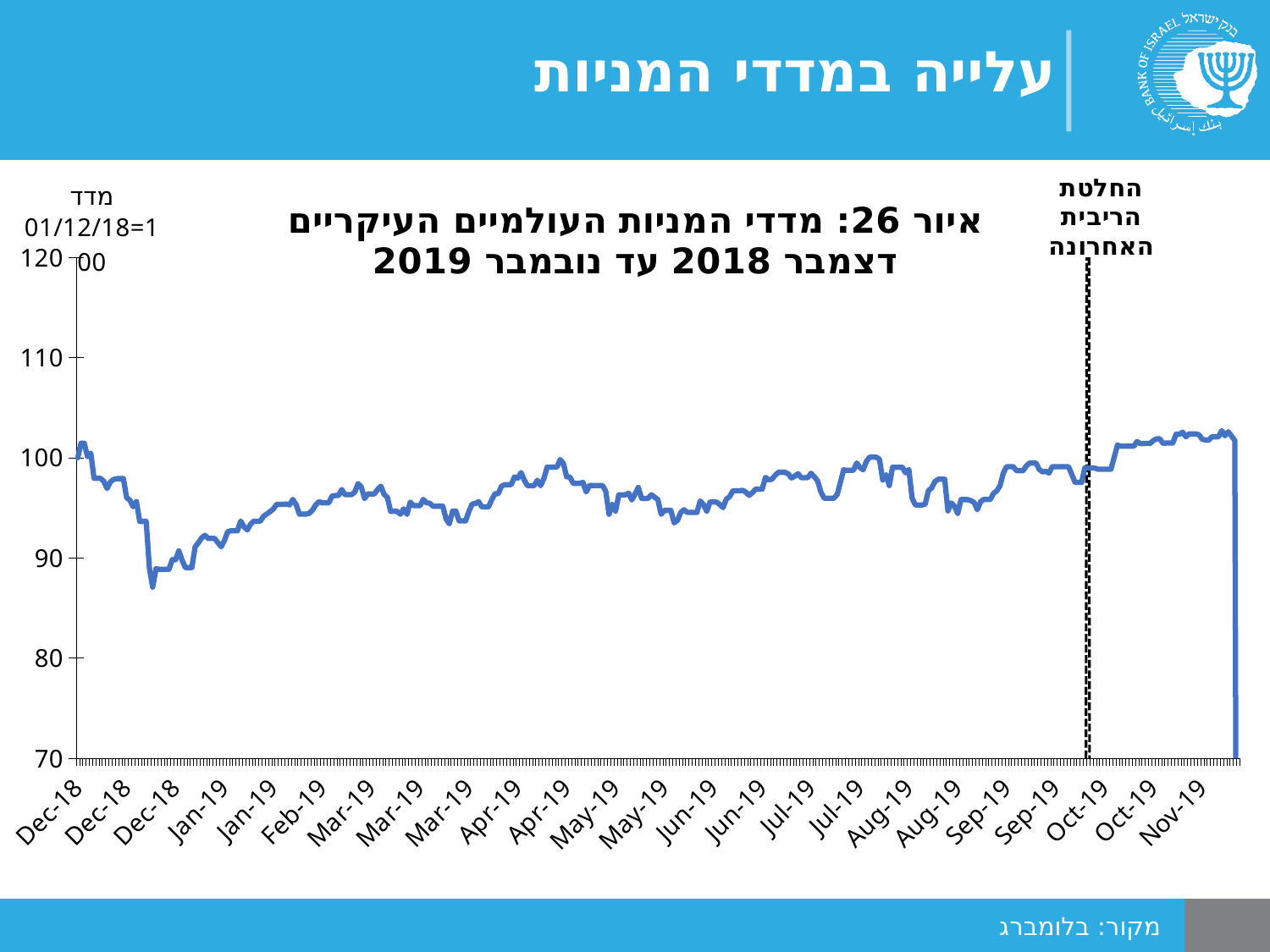
What kind of chart is shown on the slide? line chart Is the lowest point of the line, in December 2018, greater or less than 90? less What is the lowest value shown on the vertical axis? 70 Does the index rise or fall between the dashed vertical line in October 2019 and November 2019? rise What source is cited at the bottom of the slide? בלומברג Is the value of the index in mid-August 2019 greater or less than 100? less Is the value of the index in November 2019 greater or less than 100? greater Does the index rise or fall from its low in December 2018 to February 2019? rise Which is higher, the index value in November 2019 or the index value in June 2019? November 2019 In which month does the line reach its lowest point? Dec-18 What is the title of the chart? איור 26: מדדי המניות העולמיים העיקריים דצמבר 2018 עד נובמבר 2019